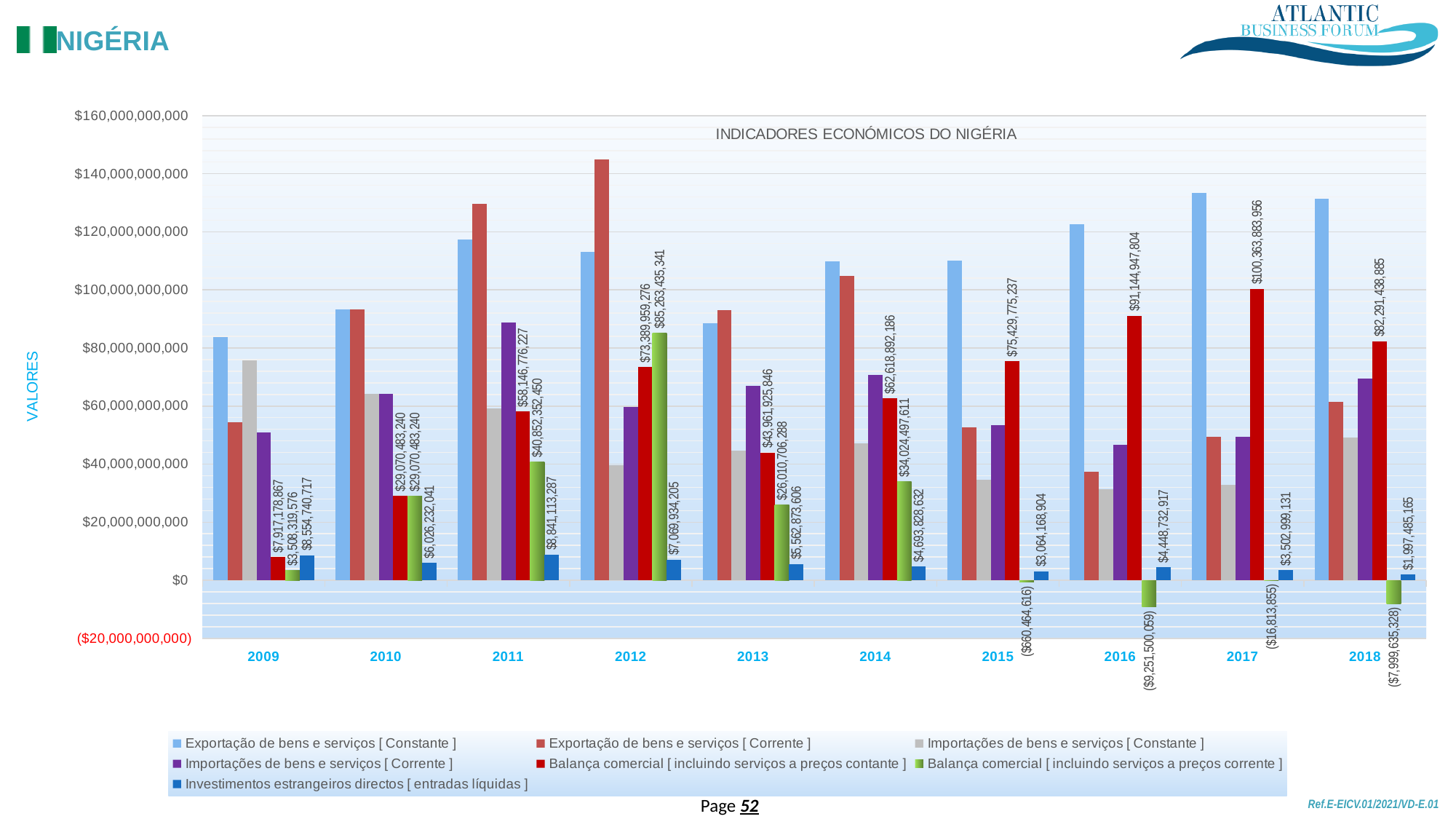
What is the title of the chart? INDICADORES ECONÓMICOS DO NIGÉRIA What is the value of Balança comercial [incluindo serviços a preços contante] in 2017? $100,363,883,956 How many series does the legend list? 7 In which year is Investimentos estrangeiros directos [entradas líquidas] lowest? 2018 How many years are shown on the x axis? 10 In 2012, which is larger: Balança comercial [incluindo serviços a preços contante] or Balança comercial [incluindo serviços a preços corrente]? Balança comercial [incluindo serviços a preços corrente] What type of chart is shown on the slide? Bar chart Is the value for Exportação de bens e serviços [Corrente] in 2012 greater or less than $140,000,000,000? greater What is the value of Investimentos estrangeiros directos [entradas líquidas] in 2009? $8,554,740,717 What is the difference between Investimentos estrangeiros directos [entradas líquidas] in 2009 and in 2010? $2,528,508,676 What is the value of Balança comercial [incluindo serviços a preços corrente] in 2016? ($9,251,500,059) In which year is Balança comercial [incluindo serviços a preços corrente] highest? 2012